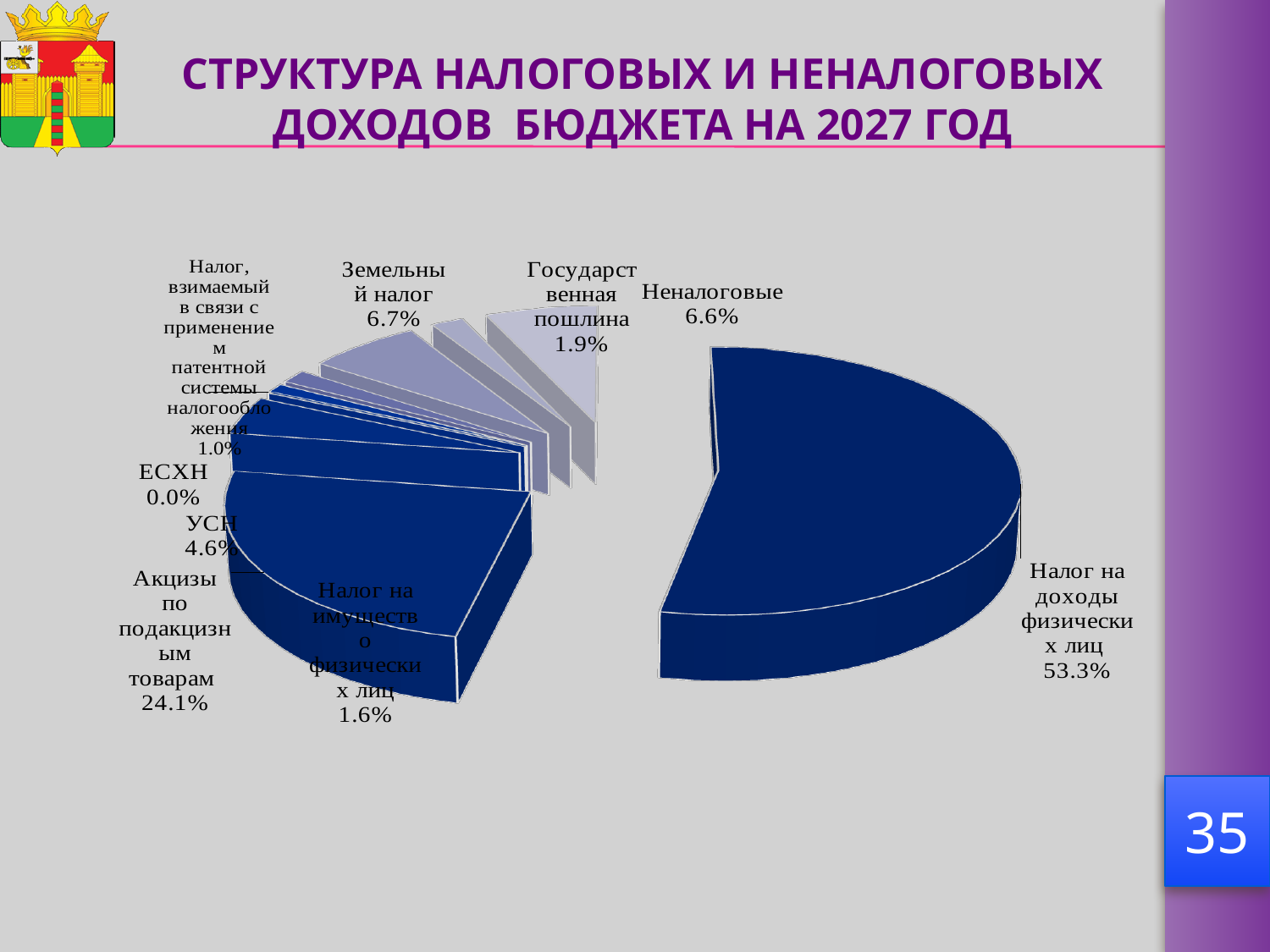
What is the value for "Неналоговые" revenues? 6.6% Which category has the smallest share of the pie? ЕСХН Which is larger: the share of "УСН" or the share of "Налог на имущество физических лиц"? УСН What percentage is shown for "Государственная пошлина"? 1.9% Which category has the largest share of the pie? Налог на доходы физических лиц What percentage is shown for "Земельный налог"? 6.7% What year does the chart title refer to? 2027 What share of the budget revenue does "Налог на доходы физических лиц" account for? 53.3% What is the difference between the shares of "Налог на доходы физических лиц" and "Акцизы по подакцизным товарам"? 29.2% What kind of chart is shown on the slide? Pie chart What is the value shown for "Акцизы по подакцизным товарам"? 24.1% How many categories are shown in the pie chart? 9